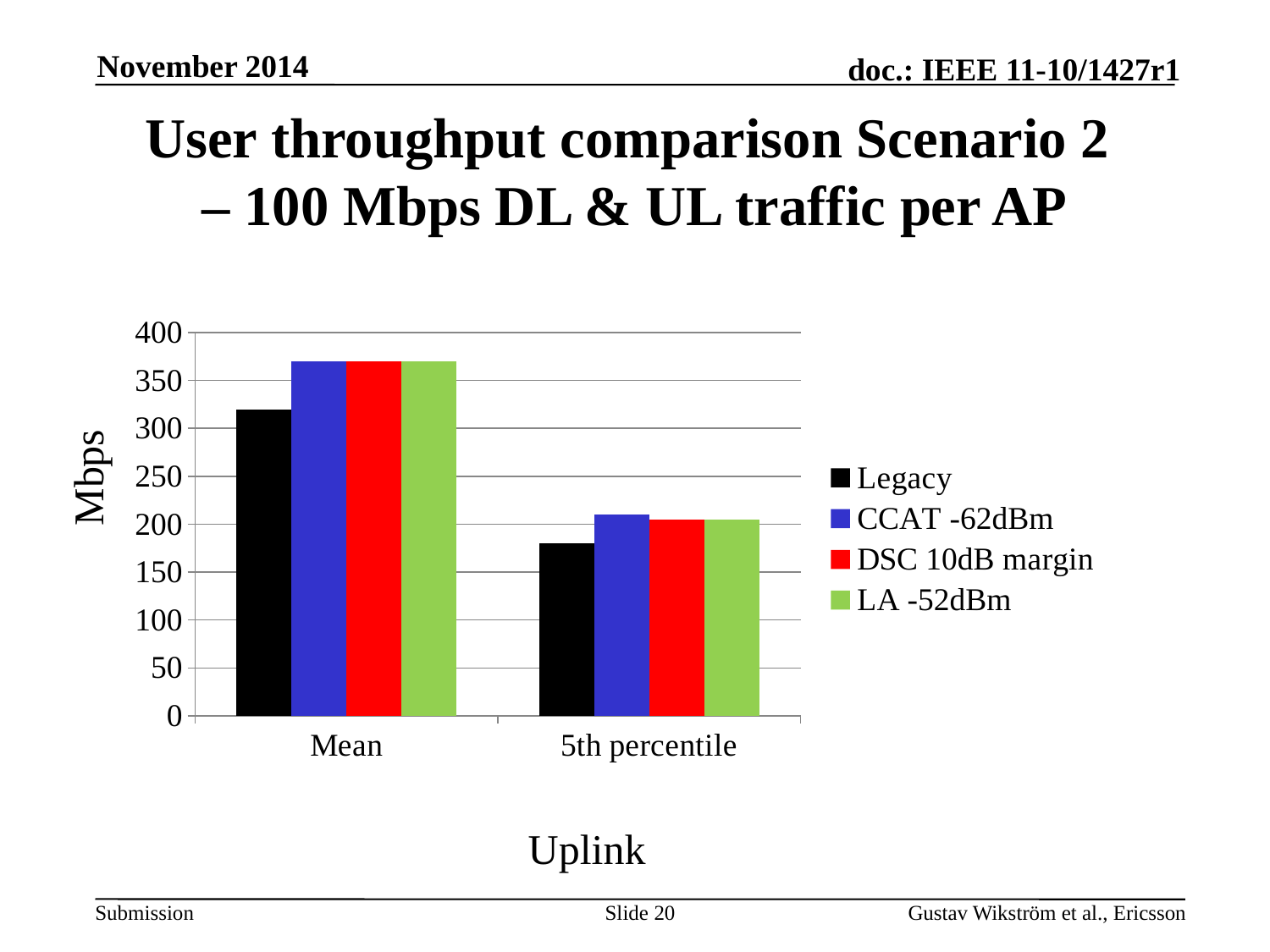
Do the values for Legacy rise or fall from Mean to 5th percentile? fall How many categories are shown on the x axis? 2 Is the value for Legacy in the 5th percentile category greater or less than 200? less What kind of chart is shown on the slide? bar chart Which series has the lowest value for the Mean category? Legacy What is the label on the y axis of the chart? Mbps Which series has the lowest value for the 5th percentile category? Legacy Is the value for Legacy in the Mean category greater or less than 300? greater Is the value for CCAT -62dBm in the Mean category greater or less than 350? greater Which is larger for the Mean category: Legacy or LA -52dBm? LA -52dBm How many series does the legend list? 4